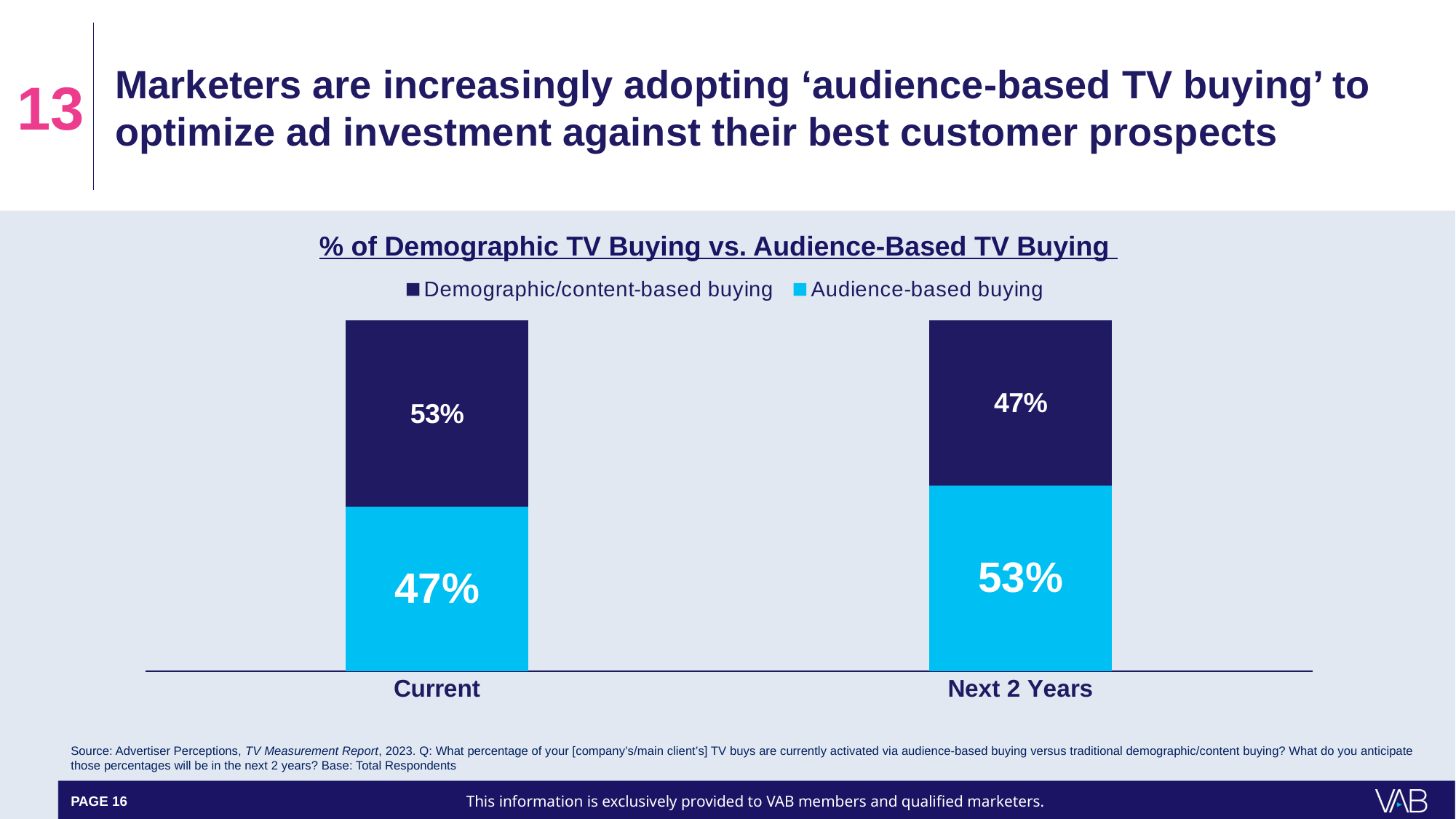
What is the value for Demographic/content-based buying in the Current bar? 53% What is the difference between Demographic/content-based buying and Audience-based buying in the Current bar? 6% What kind of chart is shown on the slide? Stacked bar chart What is the total of the Current stacked bar? 100% What is the value for Audience-based buying in the Current bar? 47% How many categories are shown on the x axis? 2 Which is larger in the Next 2 Years bar: Audience-based buying or Demographic/content-based buying? Audience-based buying What is the value for Demographic/content-based buying in the Next 2 Years bar? 47% What is the value for Audience-based buying in the Next 2 Years bar? 53% How many series does the legend list? 2 Which category has the lower Demographic/content-based buying value? Next 2 Years Which category has the higher Audience-based buying value, Current or Next 2 Years? Next 2 Years